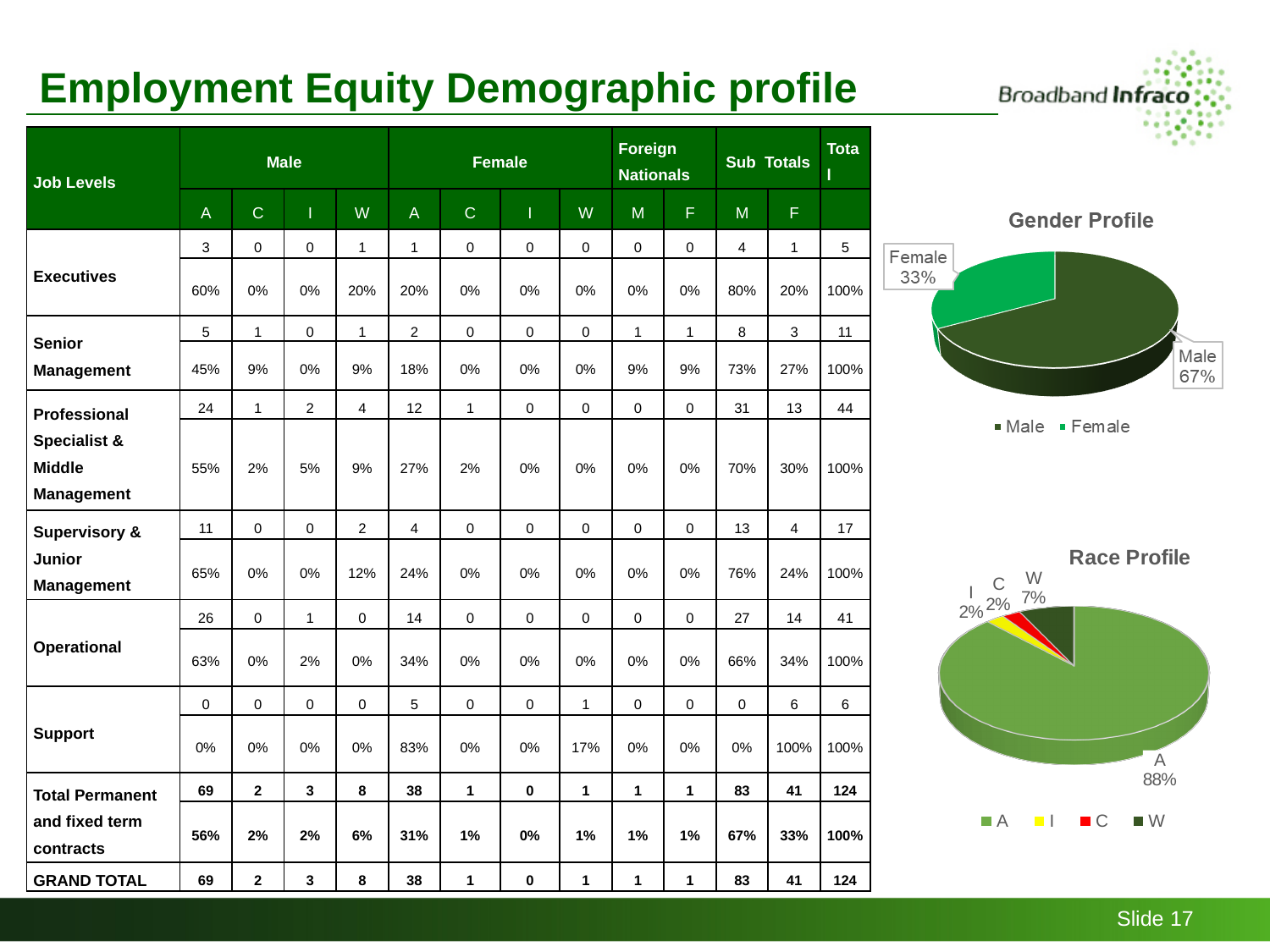
How many entries does the legend of the Gender Profile chart list? 2 In the Gender Profile chart, what is the difference in percentage points between the Male and Female slices? 34 In the Race Profile chart, which category has the largest slice? A In the Race Profile chart, which slice is larger, W or C? W In the Race Profile chart, what share of the pie is W? 7% In the Race Profile chart, what is the difference in percentage points between the A and W slices? 81 In the Gender Profile chart, what share of the pie is Female? 33% What kind of chart is the Gender Profile chart? Pie chart In the Race Profile chart, what share of the pie is A? 88% How many slices does the Race Profile pie chart have? 4 In the Gender Profile chart, which slice is larger, Male or Female? Male